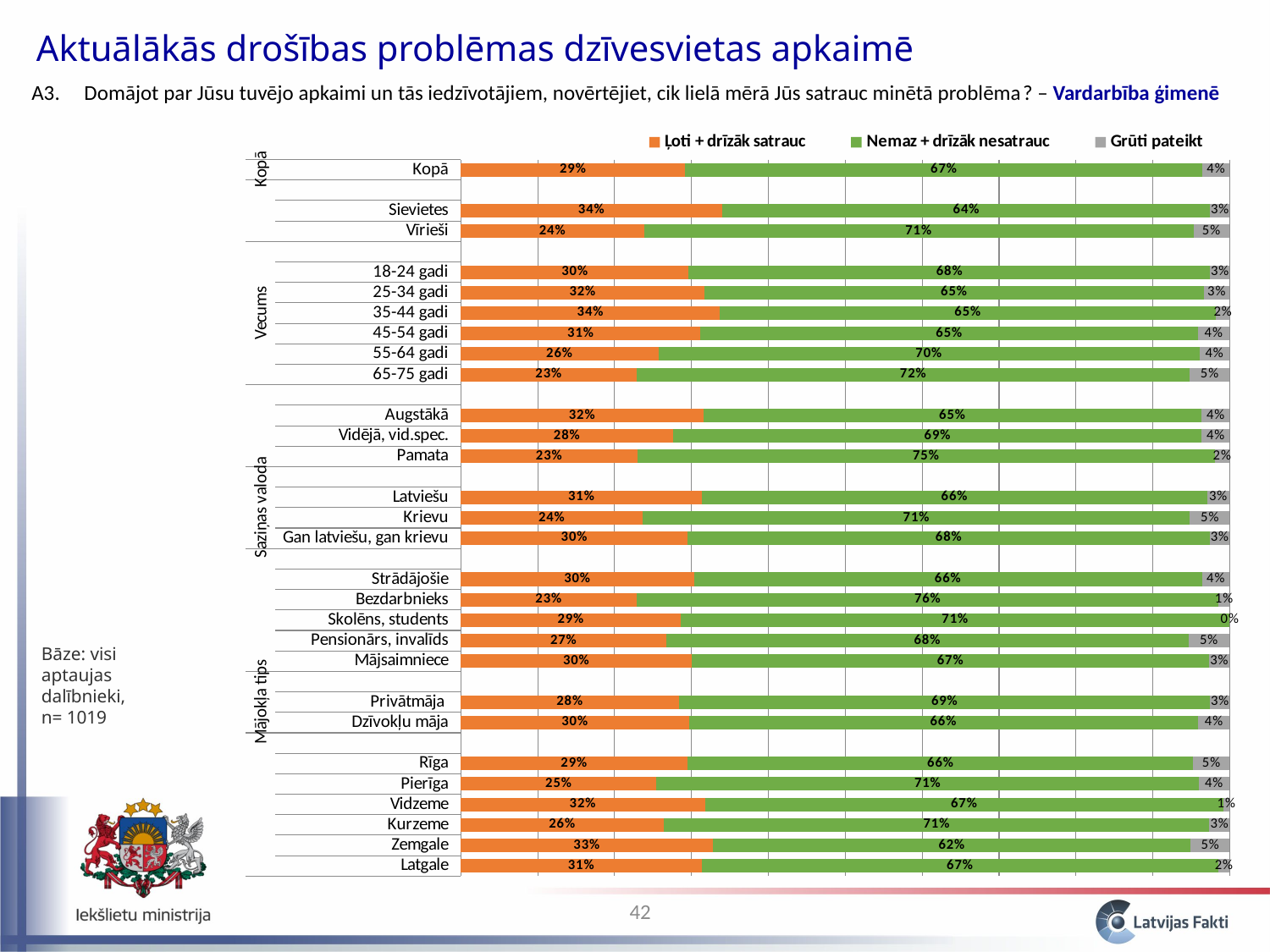
What kind of chart is shown on the slide? Stacked bar chart Which category has the highest 'Nemaz + drīzāk nesatrauc' value? Bezdarbnieks What is the total of the stacked bar for 'Kopā'? 100% What is the 'Nemaz + drīzāk nesatrauc' value for 'Bezdarbnieks'? 76% Which category has the lowest 'Nemaz + drīzāk nesatrauc' value? Zemgale What percentage of respondents in the 'Kopā' row answered 'Ļoti + drīzāk satrauc'? 29% What is the difference between the 'Ļoti + drīzāk satrauc' values for 'Sievietes' and 'Vīrieši'? 10 percentage points Which colour represents the 'Grūti pateikt' series? Grey What is the 'Grūti pateikt' value for 'Vīrieši'? 5% Which has a larger 'Ļoti + drīzāk satrauc' value, 'Zemgale' or 'Pierīga'? Zemgale How many series does the legend list? 3 How many categories (rows) are plotted in the chart? 28